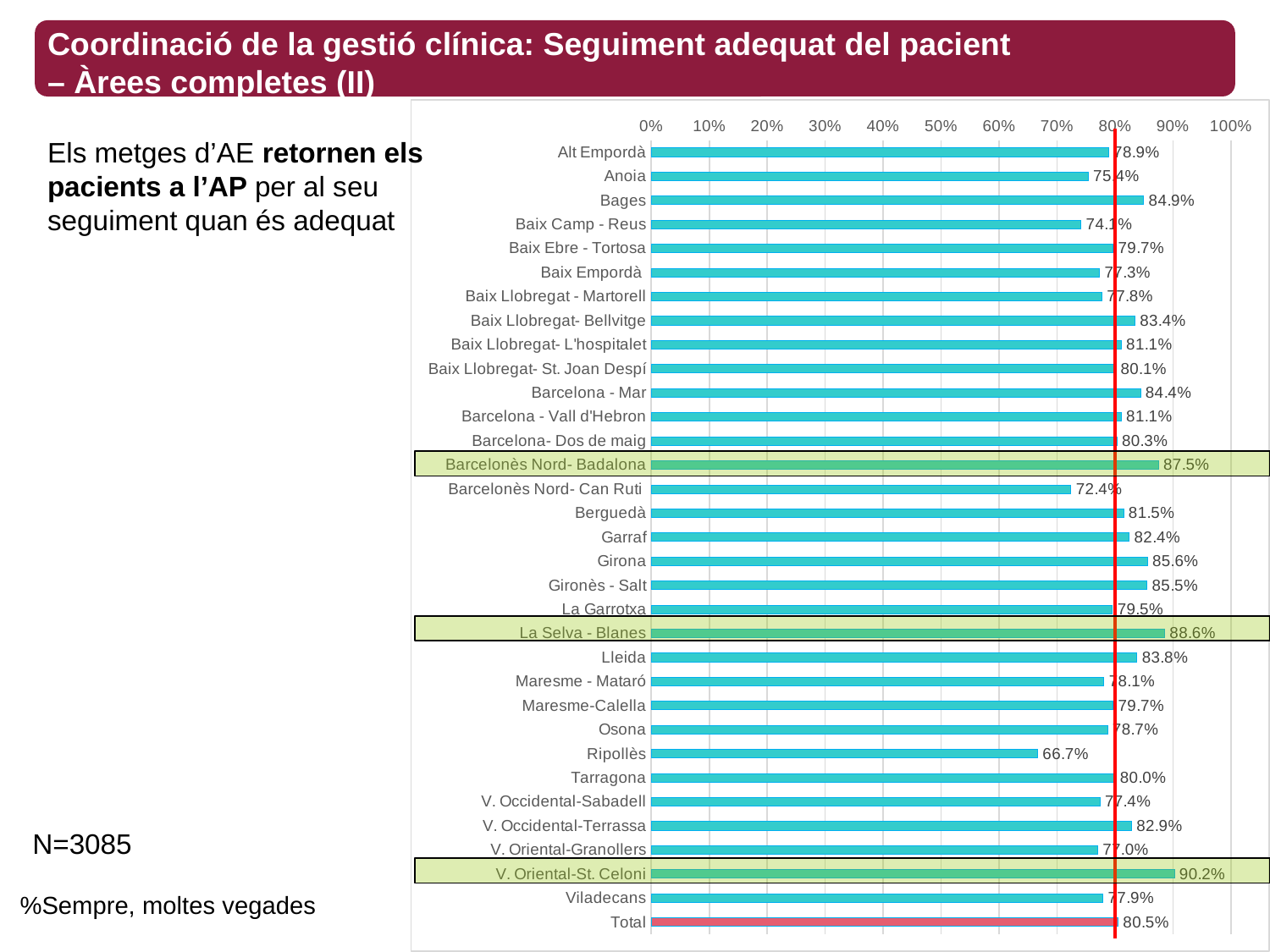
What is the value for La Selva - Blanes? 88.6% Is the value for Ripollès greater or less than 70%? less Which is larger, the value for Bages or the value for Barcelonès Nord- Can Ruti? Bages What is the value for V. Oriental-St. Celoni? 90.2% What is the difference between the values for V. Oriental-St. Celoni and Ripollès? 23.5 percentage points What is the value for Ripollès? 66.7% What is the value for the Total bar? 80.5% How many bars are plotted in the chart, including Total? 33 Which area has the highest value? V. Oriental-St. Celoni Which area has the lowest value? Ripollès What kind of chart is shown on the slide? Bar chart What is the value for Barcelonès Nord- Badalona? 87.5%